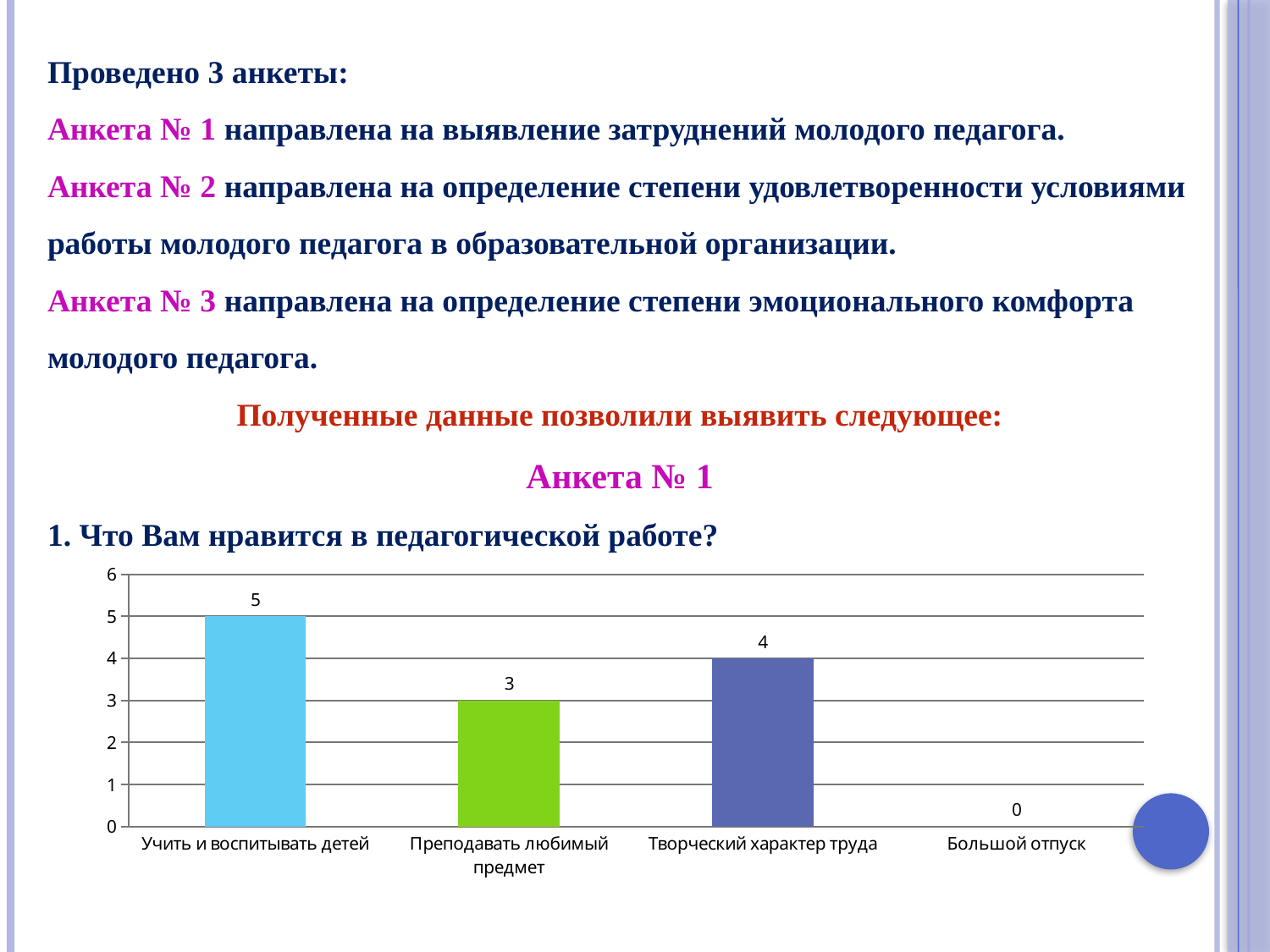
What is the maximum value shown on the vertical axis of the chart? 6 What is the value for "Учить и воспитывать детей"? 5 What is the value for "Творческий характер труда"? 4 What is the value for "Большой отпуск"? 0 What is the difference between the values for "Учить и воспитывать детей" and "Преподавать любимый предмет"? 2 Which is larger: the value for "Творческий характер труда" or the value for "Преподавать любимый предмет"? Творческий характер труда How many categories are shown on the x axis of the chart? 4 Which category has the highest value? Учить и воспитывать детей What question does the chart on the slide illustrate? 1. Что Вам нравится в педагогической работе? Which category has the lowest value? Большой отпуск What kind of chart is shown on the slide? bar chart What is the value for "Преподавать любимый предмет"? 3